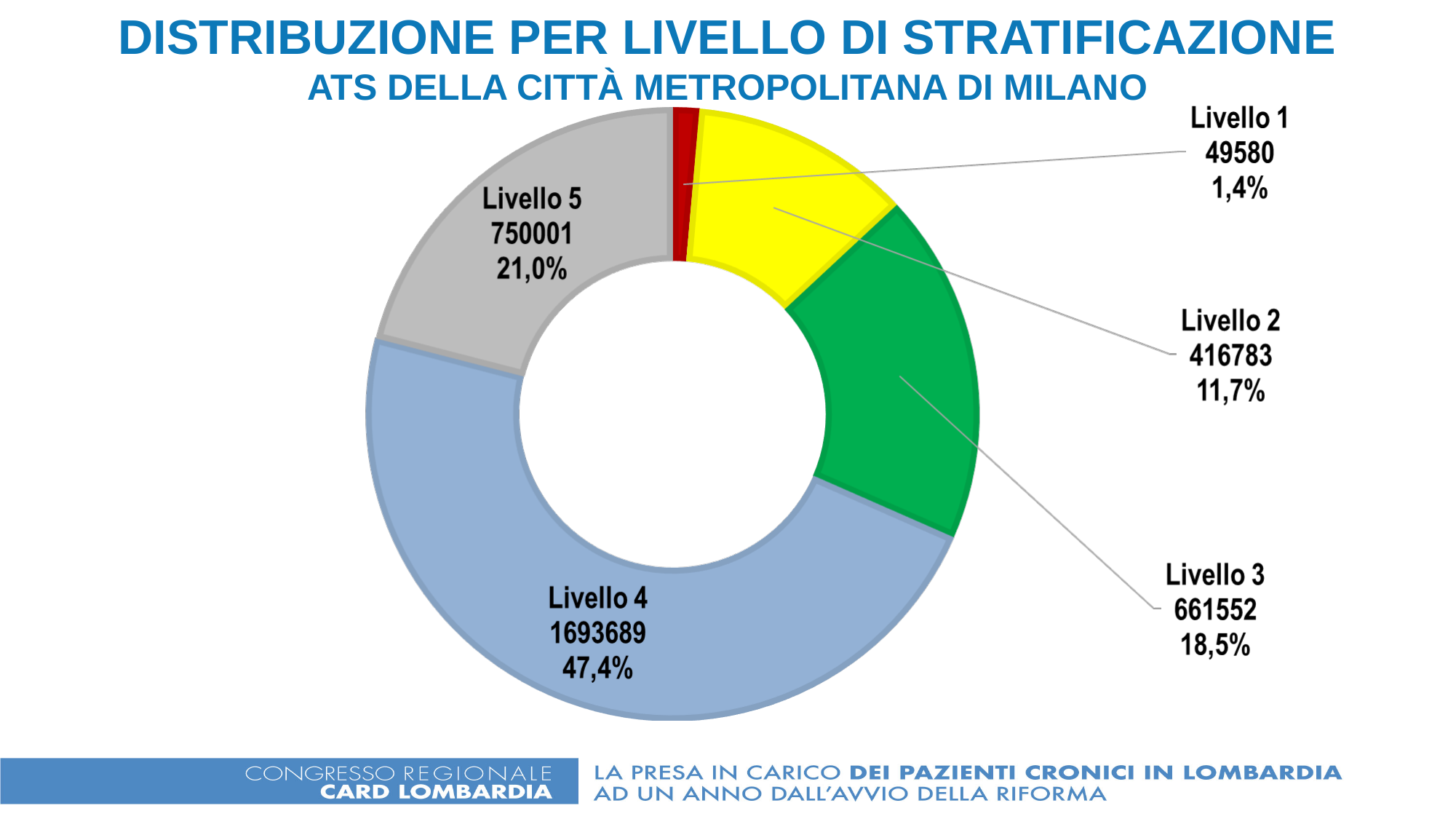
Which is larger, the value for Livello 3 or the value for Livello 2? Livello 3 What percentage share is shown for Livello 5? 21,0% What kind of chart is shown on the slide? Doughnut (pie) chart What is the difference between the values for Livello 4 and Livello 5? 943688 What is the value shown for Livello 4? 1693689 What is the difference between the values for Livello 5 and Livello 3? 88449 How many levels (categories) are shown in the chart? 5 Which level has the largest share of the chart? Livello 4 Which level has the smallest share of the chart? Livello 1 What is the value shown for Livello 1? 49580 What percentage share is shown for Livello 2? 11,7% What colour is the segment for Livello 3? Green